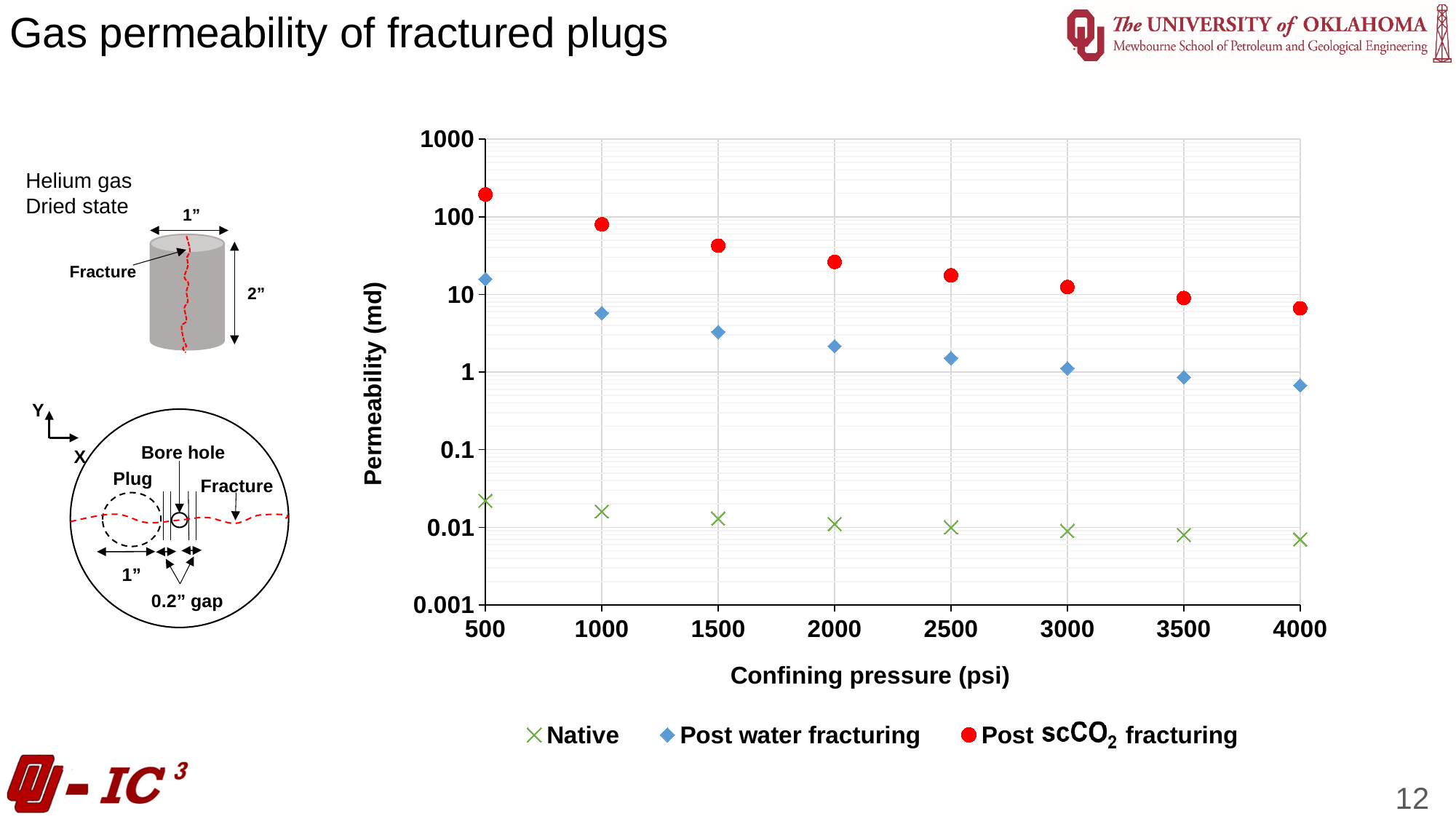
What kind of chart is shown on the slide? Scatter chart Is the Native permeability at 4000 psi greater or less than 0.01 md? less Which series has the lowest permeability across all confining pressures? Native How many series does the legend list? 3 What is the title of the x axis? Confining pressure (psi) At 2000 psi, which is larger: the Post water fracturing permeability or the Post scCO2 fracturing permeability? Post scCO2 fracturing Which series has the highest permeability at 500 psi? Post scCO2 fracturing How many confining pressure points are plotted for each series? 8 Is the Post water fracturing permeability at 4000 psi greater or less than 1 md? less Does the permeability for Post scCO2 fracturing rise or fall as confining pressure increases? Fall Is the Post water fracturing permeability at 500 psi greater or less than 10 md? greater